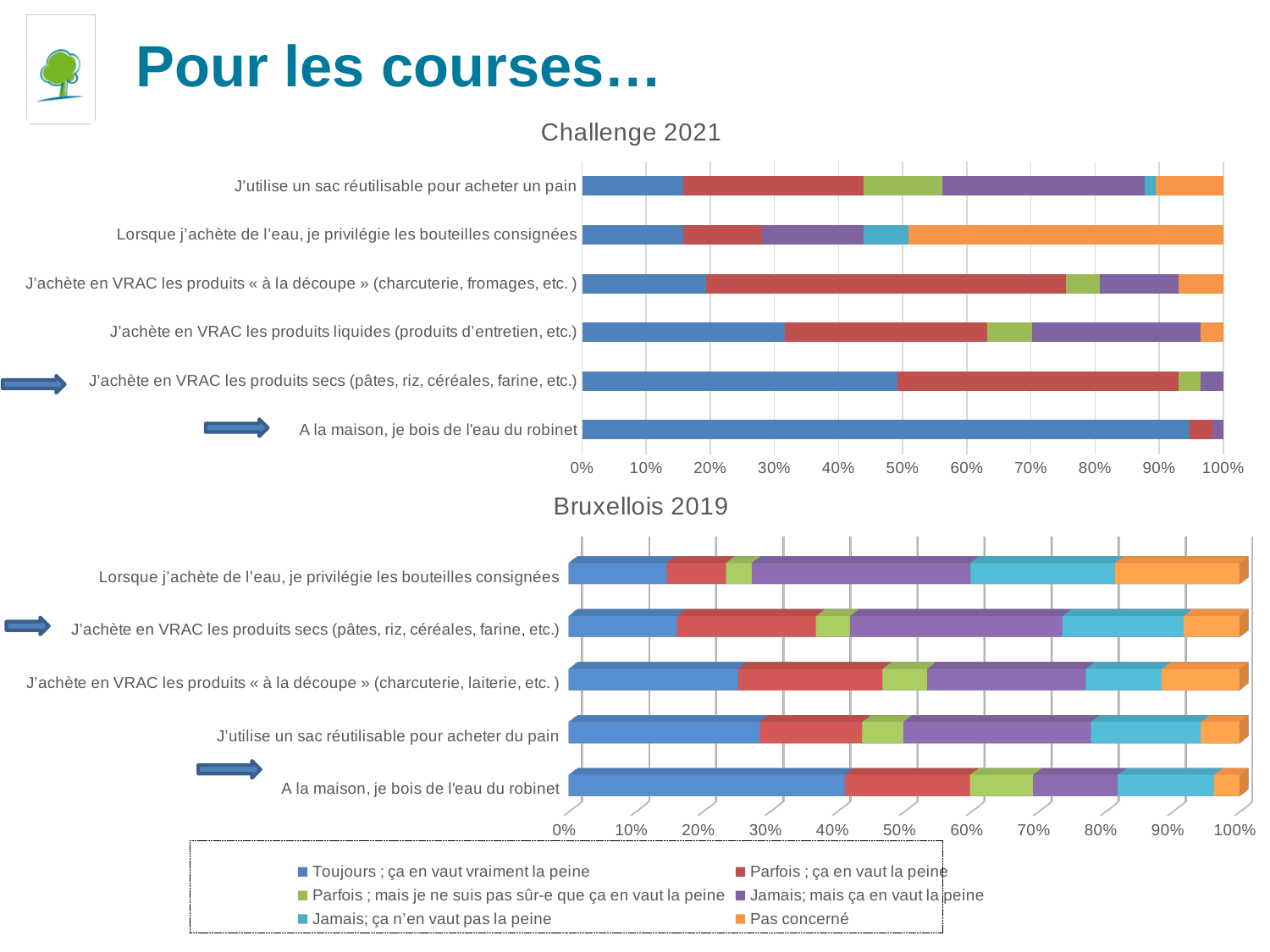
Which legend entry is shown in orange? Pas concerné In the 'Bruxellois 2019' chart, is the 'Toujours ; ça en vaut vraiment la peine' share for 'A la maison, je bois de l'eau du robinet' greater or less than 30%? greater In the 'Challenge 2021' chart, which has the larger 'Toujours ; ça en vaut vraiment la peine' share: 'J'achète en VRAC les produits liquides' or 'J'achète en VRAC les produits « à la découpe »'? J'achète en VRAC les produits liquides In the 'Challenge 2021' chart, which statement has the largest 'Toujours ; ça en vaut vraiment la peine' share? A la maison, je bois de l'eau du robinet In the 'Bruxellois 2019' chart, which statement has the largest 'Toujours ; ça en vaut vraiment la peine' share? A la maison, je bois de l'eau du robinet How many categories (statements) are shown in the 'Challenge 2021' chart? 6 How many series does the legend list? 6 How many categories (statements) are shown in the 'Bruxellois 2019' chart? 5 In the 'Challenge 2021' chart, is the 'Toujours ; ça en vaut vraiment la peine' share for 'A la maison, je bois de l'eau du robinet' greater or less than 90%? greater In the 'Challenge 2021' chart, is the 'Toujours ; ça en vaut vraiment la peine' share for 'J'achète en VRAC les produits secs (pâtes, riz, céréales, farine, etc.)' greater or less than 40%? greater What kind of chart is the 'Challenge 2021' chart? Stacked bar chart In the 'Challenge 2021' chart, which statement has the largest 'Pas concerné' share? Lorsque j'achète de l'eau, je privilégie les bouteilles consignées